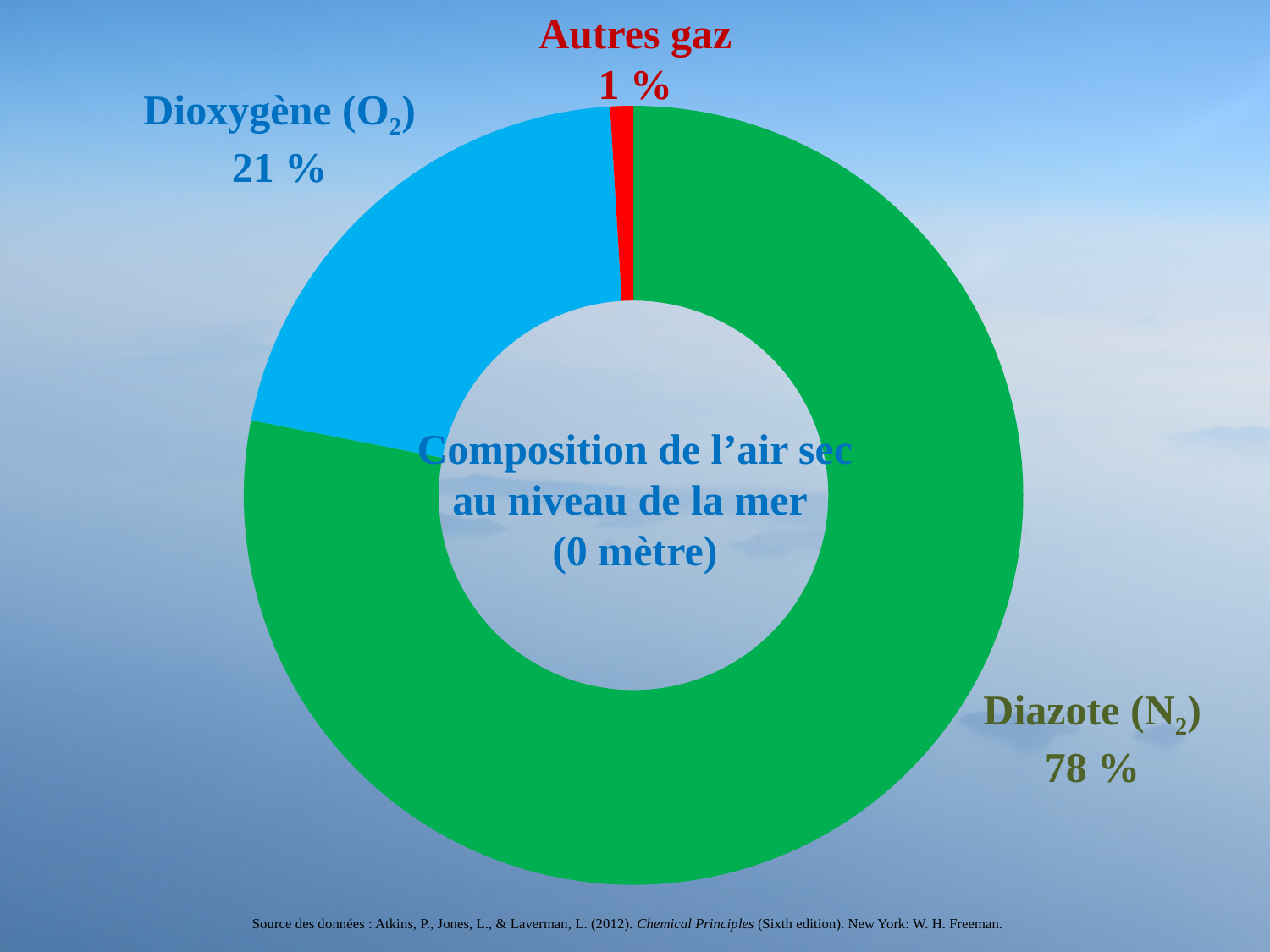
What is the difference in percentage points between the Diazote (N2) share and the Dioxygène (O2) share? 57 Which category has the smallest share in the chart? Autres gaz Which is larger, the share of Dioxygène (O2) or the share of Autres gaz? Dioxygène (O2) What kind of chart is shown on the slide? Pie chart (doughnut) Which gas has the largest share in the chart? Diazote (N2) What is the combined share of Dioxygène (O2) and Autres gaz? 22 % What share of dry air at sea level is Dioxygène (O2) according to the chart? 21 % What share of dry air at sea level is Diazote (N2) according to the chart? 78 % What share of dry air at sea level is Autres gaz according to the chart? 1 % What colour is the Dioxygène (O2) slice in the chart? Blue How many categories are shown in the chart? 3 What is the title shown in the centre of the chart? Composition de l'air sec au niveau de la mer (0 mètre)